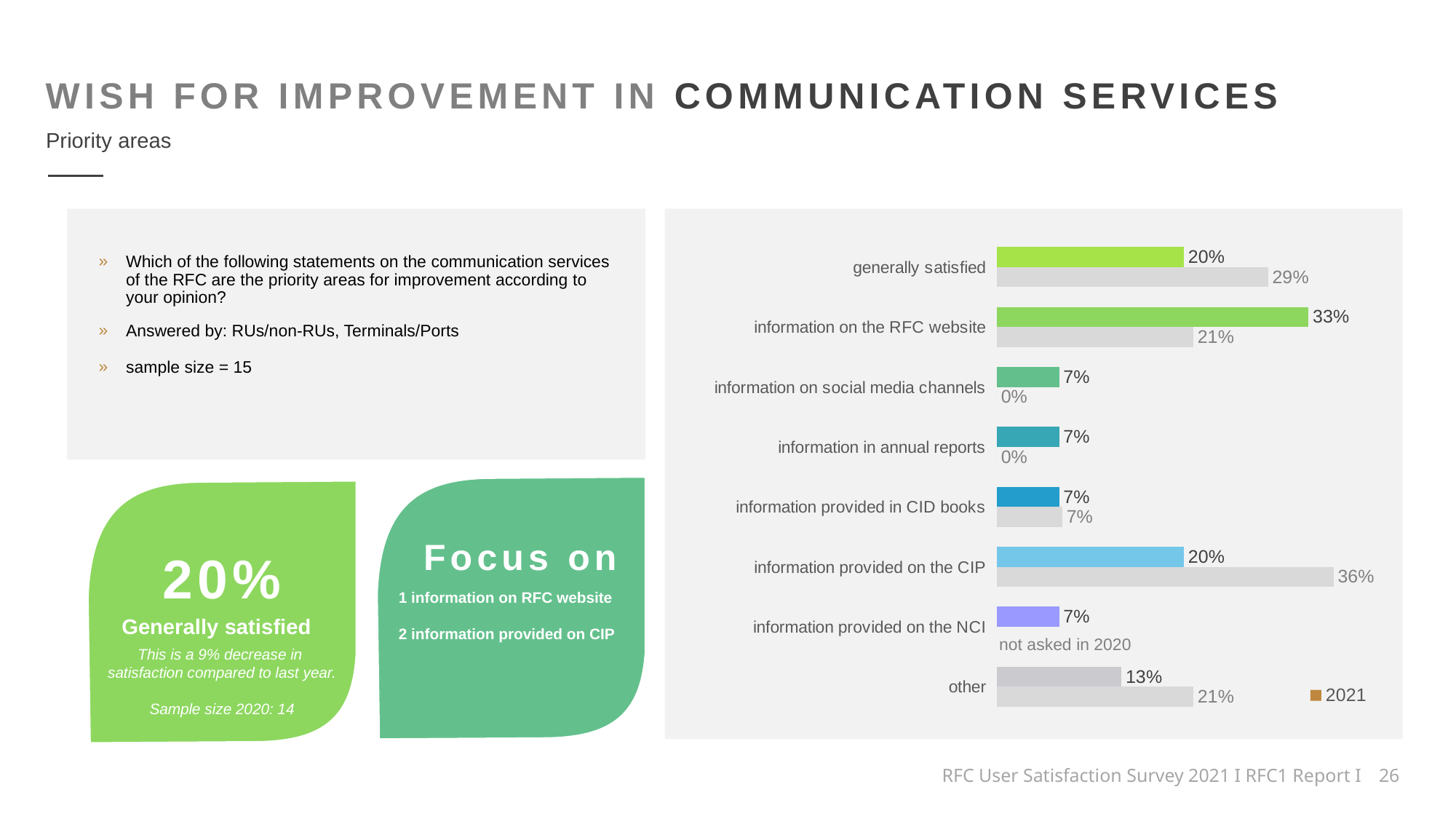
What is the difference between the 2020 and 2021 values for 'information provided on the CIP'? 16% Which is larger for 'information on the RFC website': the 2021 value or the 2020 value? 2021 What is the difference between the 2021 and 2020 values for 'generally satisfied'? 9% How many categories are shown on the chart? 8 What is the 2021 value for 'other'? 13% Which category has the highest 2020 (grey bar) value? information provided on the CIP What is the 2021 value for 'information on the RFC website'? 33% What is the 2021 value for 'generally satisfied'? 20% Which category has the highest 2021 value? information on the RFC website What kind of chart is shown on the slide? bar chart What is the 2020 value (grey bar) for 'information provided on the CIP'? 36% What is shown in place of a 2020 value for 'information provided on the NCI'? not asked in 2020